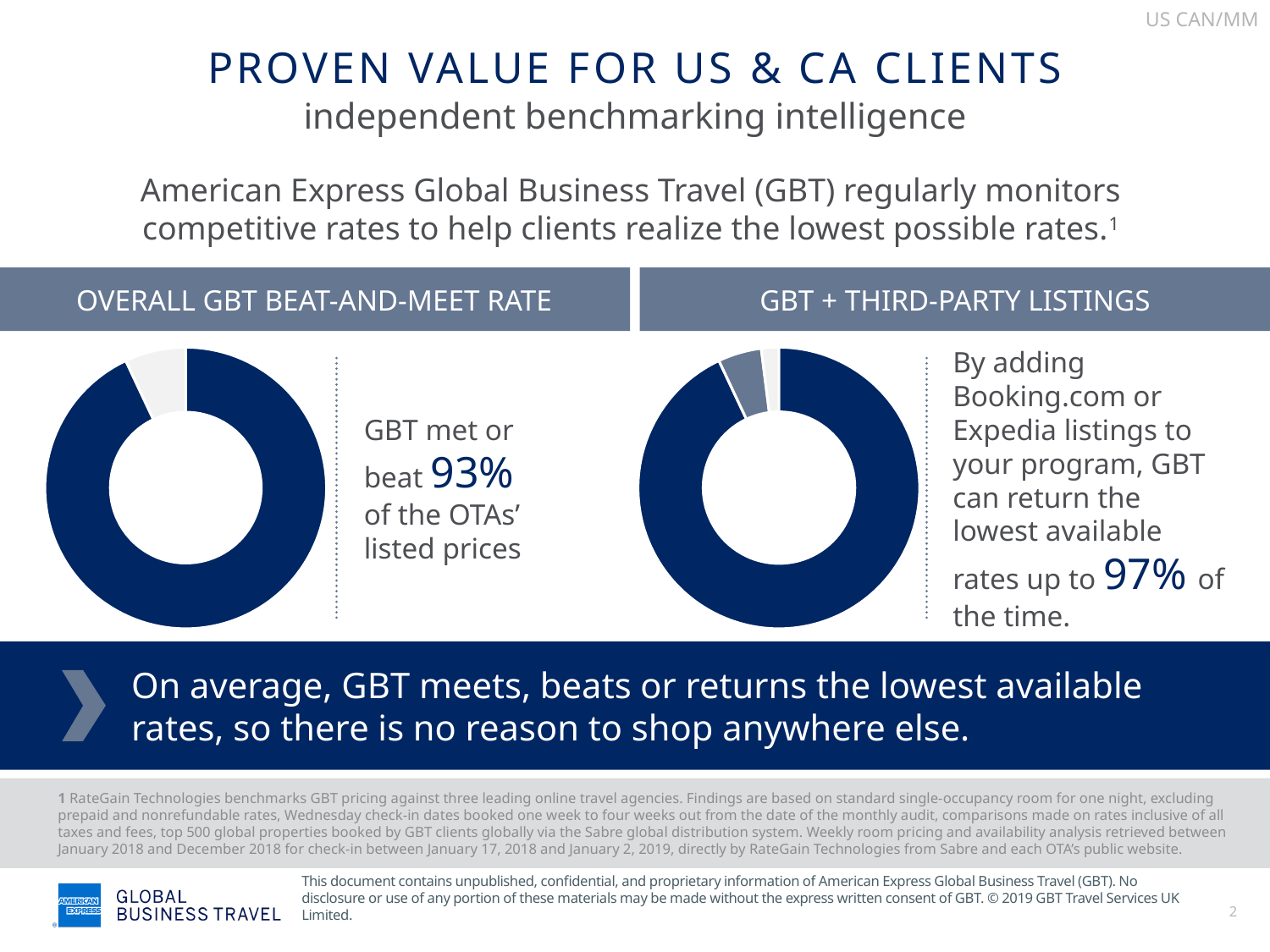
How many donut charts are on the slide? 2 In the GBT + THIRD-PARTY LISTINGS chart, how many slices does the donut have? 3 In the OVERALL GBT BEAT-AND-MEET RATE chart, what percentage of the OTAs' listed prices did GBT meet or beat? 93% In the OVERALL GBT BEAT-AND-MEET RATE chart, is the dark blue share greater or less than 50%? greater What kind of chart is shown under the heading OVERALL GBT BEAT-AND-MEET RATE? Donut (pie) chart In the OVERALL GBT BEAT-AND-MEET RATE chart, how many slices does the donut have? 2 What is the difference between the 97% in the GBT + THIRD-PARTY LISTINGS chart and the 93% in the OVERALL GBT BEAT-AND-MEET RATE chart? 4% In the GBT + THIRD-PARTY LISTINGS chart, up to what percentage of the time can GBT return the lowest available rates? 97% What kind of chart is shown under the heading GBT + THIRD-PARTY LISTINGS? Donut (pie) chart Which third-party listings are named next to the GBT + THIRD-PARTY LISTINGS chart? Booking.com or Expedia What colour is the largest slice in the OVERALL GBT BEAT-AND-MEET RATE chart? Dark blue